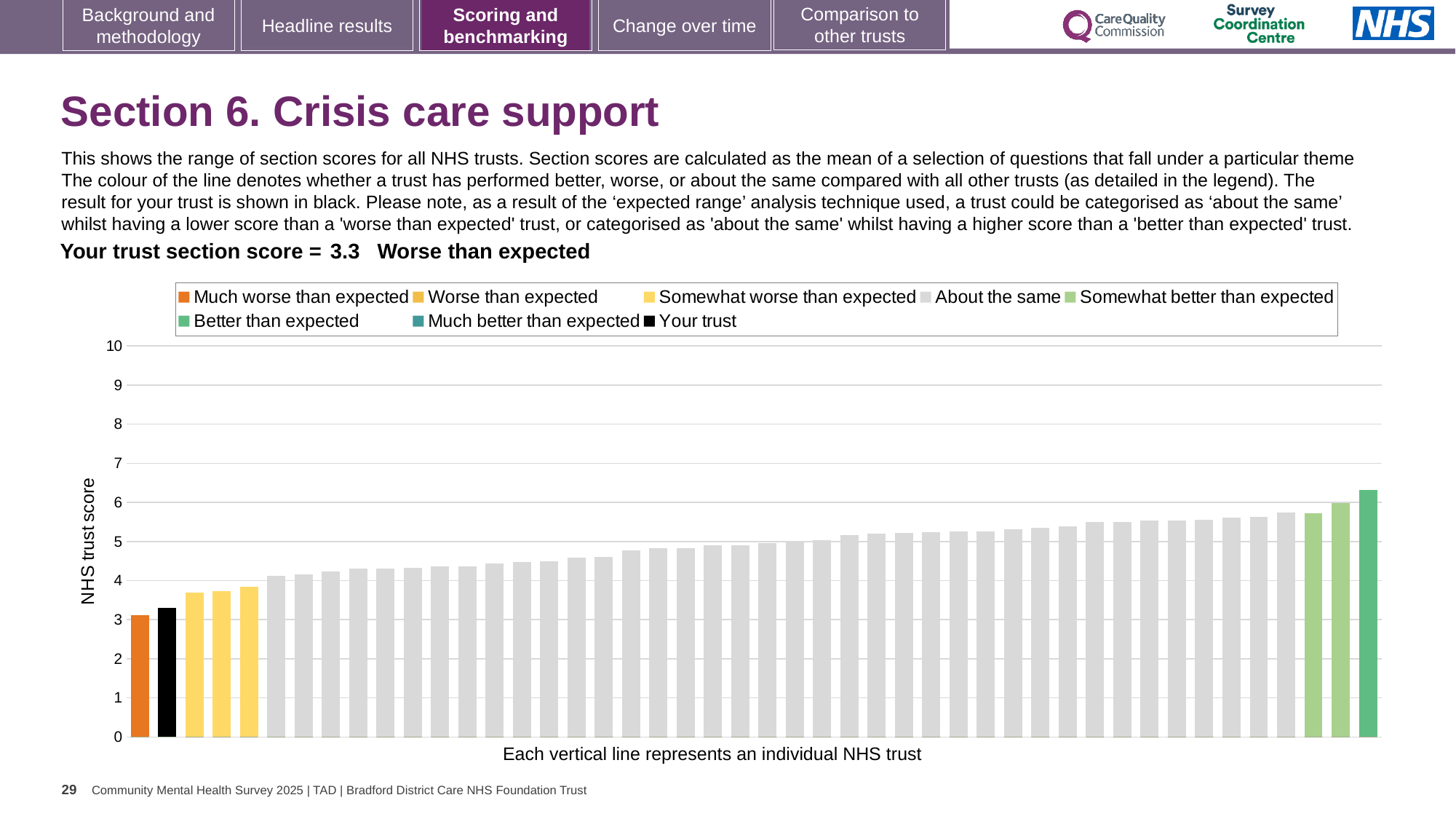
How many entries does the chart legend list? 8 Which category is your trust's section score placed in, according to the slide? Worse than expected How many bars are coloured as 'Somewhat better than expected' (light green)? 2 What kind of chart is shown on the slide? bar chart Is the value for your trust (the black bar) greater or less than 4? less Is the value of the tallest bar in the chart greater or less than 6? greater What is the label on the vertical axis of the chart? NHS trust score What is the section score for your trust shown on the slide? 3.3 Do the bar values rise or fall from left to right across the chart? rise How many bars are coloured as 'Somewhat worse than expected' (light yellow)? 3 Is the value of the orange 'Much worse than expected' bar greater or less than 4? less Which is taller, the orange 'Much worse than expected' bar or the black 'Your trust' bar? the black 'Your trust' bar